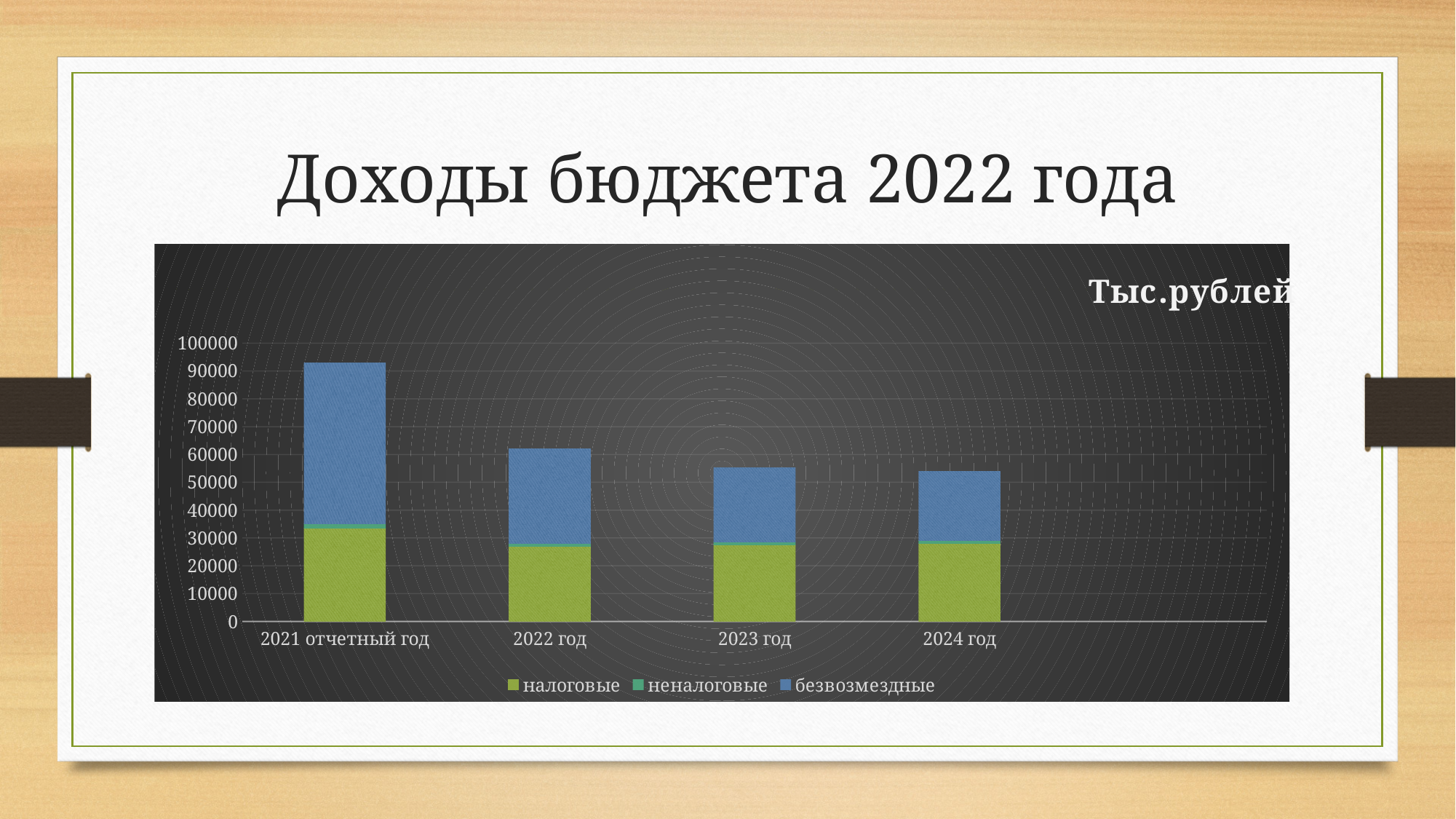
Is the total value for 2021 отчетный год greater or less than 90000? greater What kind of chart is shown on the slide? stacked bar chart Is the total value for 2023 год greater or less than 60000? less Is the налоговые value for 2022 год greater or less than 30000? less Do the total bar heights rise or fall from 2021 to 2024? fall How many series does the legend list? 3 How many categories (years) are shown on the x axis? 4 Which total bar is larger, 2021 отчетный год or 2022 год? 2021 отчетный год What unit label is shown in the top right corner of the chart? Тыс.рублей Which year has the highest total bar? 2021 отчетный год